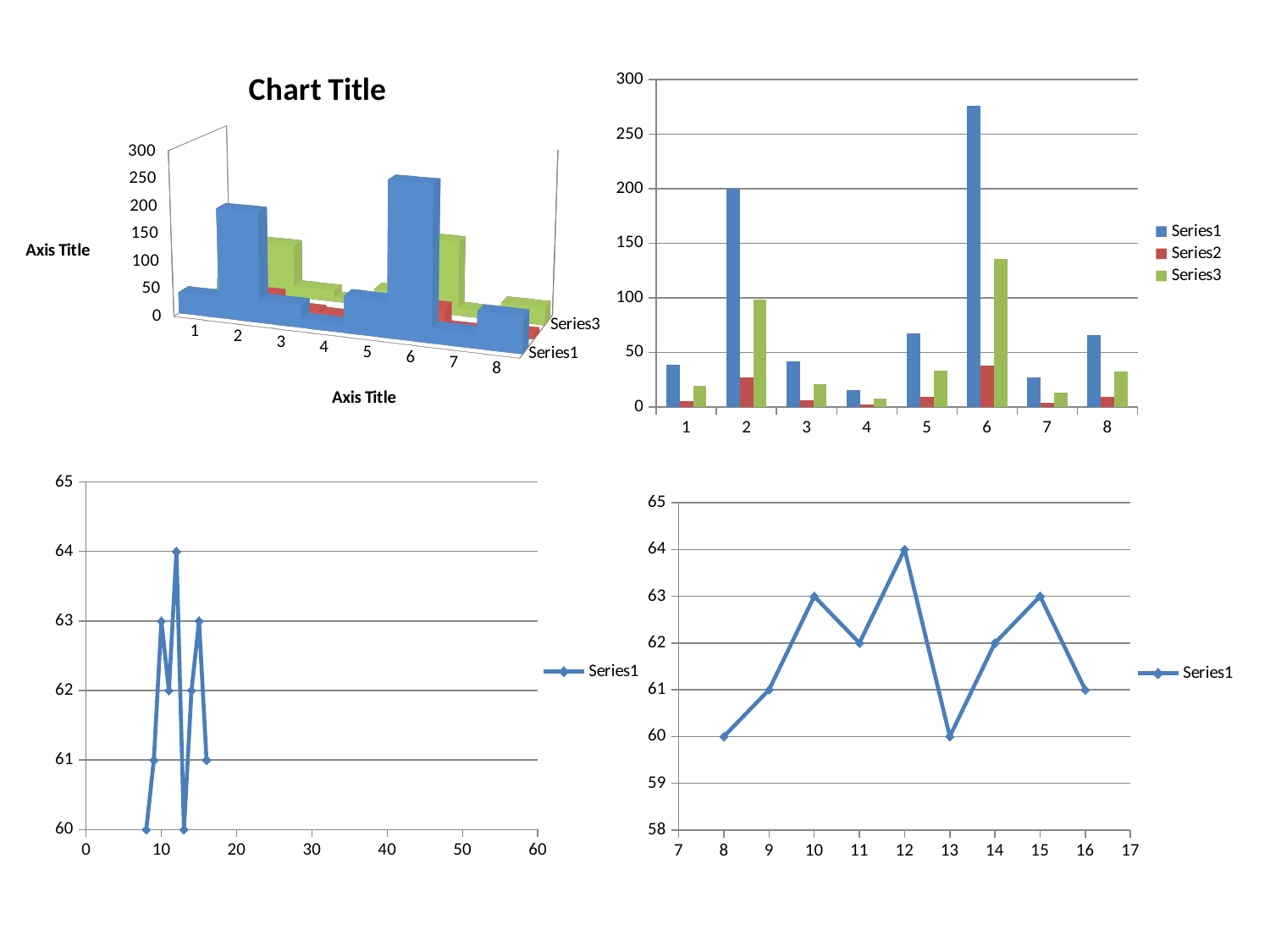
In the top-right bar chart, which is larger for category 5: Series1 or Series3? Series1 In the top-right bar chart, which category has the highest Series1 value? 6 In the top-right bar chart, how many categories are shown on the x axis? 8 In the bottom-right line chart, how many data points are plotted? 9 What is the title of the top-left chart? Chart Title In the bottom-right line chart, what is the value at x = 13? 60 In the top-right bar chart, how many series does the legend list? 3 In the bottom-right line chart, what is the value at x = 12? 64 What kind of chart is the bottom-right chart? line chart In the top-right bar chart, is the Series1 value for category 6 greater or less than 250? greater In the bottom-right line chart, what is the difference between the values at x = 12 and x = 13? 4